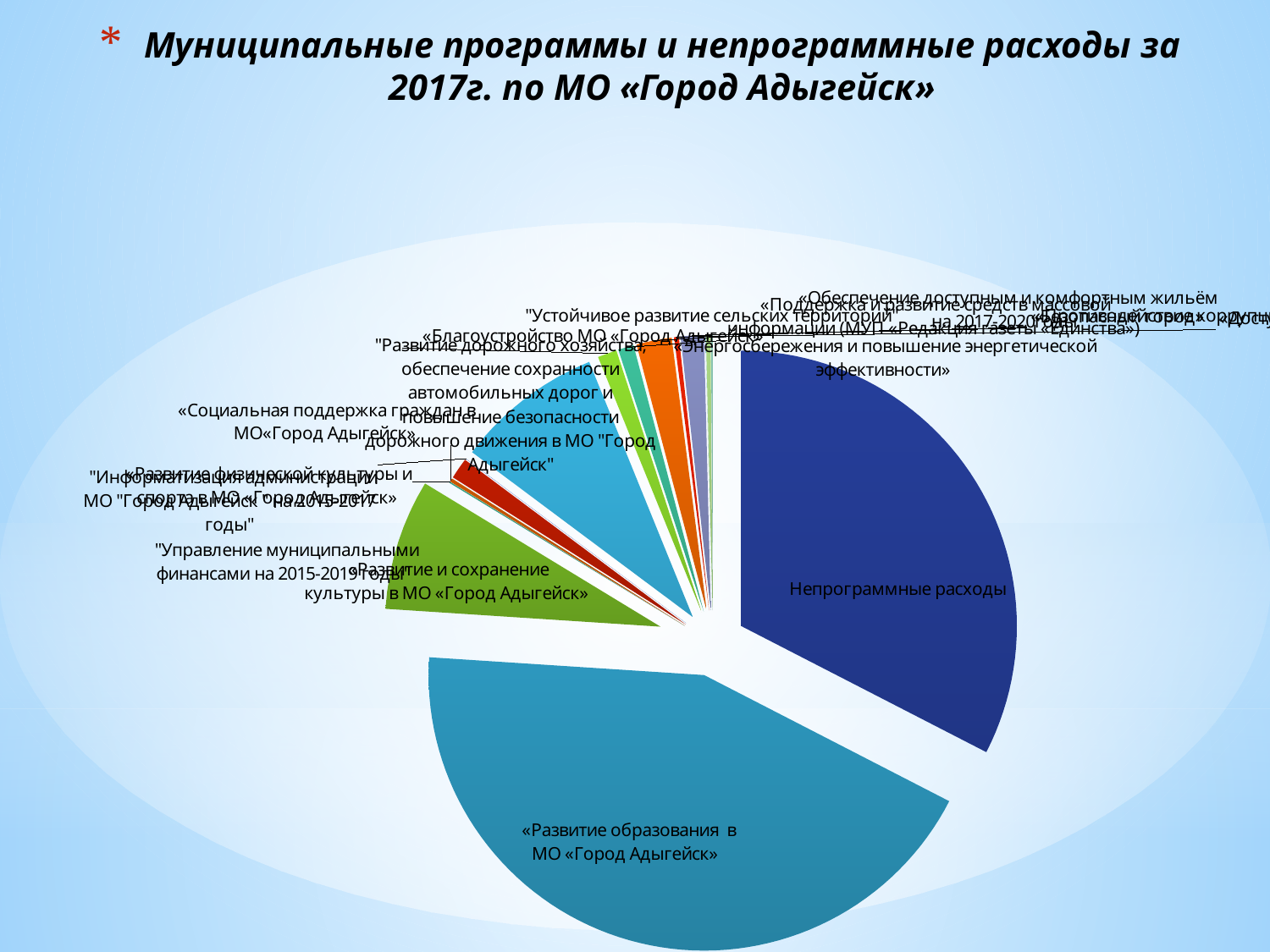
What colour is the slice for Непрограммные расходы? Dark blue What is the title of the slide containing the chart? Муниципальные программы и непрограммные расходы за 2017г. по МО «Город Адыгейск» What kind of chart is shown on the slide? Pie chart Which category has the largest slice of the pie? «Развитие образования в МО «Город Адыгейск» Which slice is larger: «Развитие образования в МО «Город Адыгейск» or Непрограммные расходы? «Развитие образования в МО «Город Адыгейск» Which slice is larger: Непрограммные расходы or Развитие и сохранение культуры в МО «Город Адыгейск»? Непрограммные расходы Which slice is larger: Развитие и сохранение культуры в МО «Город Адыгейск» or «Социальная поддержка граждан в МО«Город Адыгейск»? Развитие и сохранение культуры в МО «Город Адыгейск»